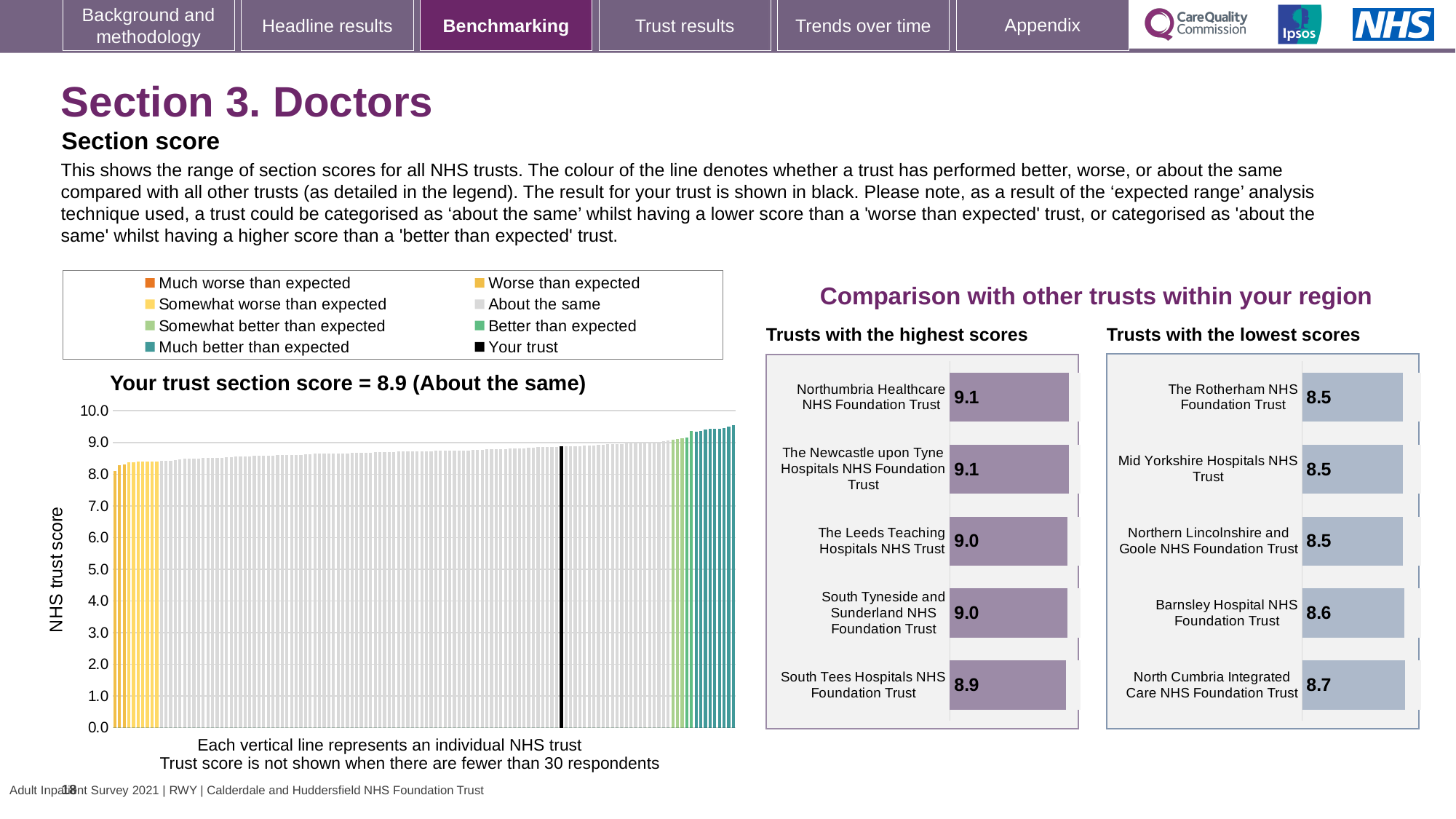
In the 'Trusts with the lowest scores' chart, which trust has the highest score? North Cumbria Integrated Care NHS Foundation Trust In the 'Trusts with the highest scores' chart, what is the score for Northumbria Healthcare NHS Foundation Trust? 9.1 In the chart on the left, do the trust scores rise or fall from left to right along the x axis? Rise According to the title of the chart on the left, what is your trust's section score? 8.9 (About the same) In the 'Trusts with the highest scores' chart, what is the difference between the scores of Northumbria Healthcare NHS Foundation Trust and South Tees Hospitals NHS Foundation Trust? 0.2 In the 'Trusts with the lowest scores' chart, what is the score for Barnsley Hospital NHS Foundation Trust? 8.6 What kind of chart is the large chart on the left showing all NHS trusts? Bar chart In the 'Trusts with the highest scores' chart, how many trusts are listed? 5 In the 'Trusts with the lowest scores' chart, what is the score for North Cumbria Integrated Care NHS Foundation Trust? 8.7 In the 'Trusts with the lowest scores' chart, which has the larger score: North Cumbria Integrated Care NHS Foundation Trust or Barnsley Hospital NHS Foundation Trust? North Cumbria Integrated Care NHS Foundation Trust In the 'Trusts with the highest scores' chart, which trust has the lowest score? South Tees Hospitals NHS Foundation Trust How many entries does the legend above the chart on the left list? 8